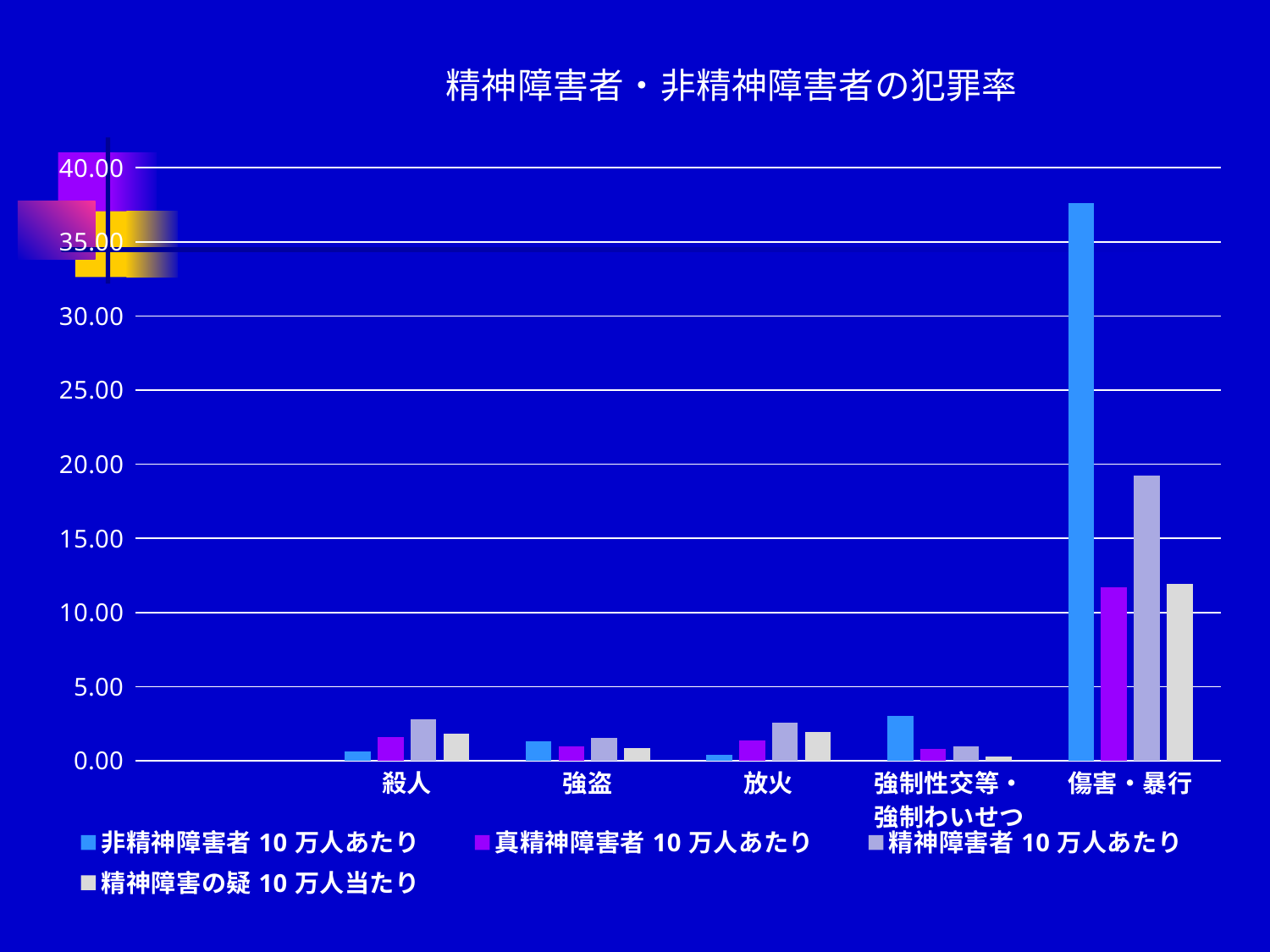
How many crime categories are shown on the x axis? 5 Which category has the highest value for 非精神障害者 10万人あたり? 傷害・暴行 Is the value for 精神障害者 10万人あたり in 傷害・暴行 greater or less than 15.00? greater Is the value for 精神障害者 10万人あたり in 殺人 greater or less than 5.00? less Is the value for 非精神障害者 10万人あたり in 傷害・暴行 greater or less than 30.00? greater What kind of chart is shown on the slide? bar chart In 傷害・暴行, which is larger: 精神障害者 10万人あたり or 真精神障害者 10万人あたり? 精神障害者 10万人あたり How many series does the legend list? 4 In 傷害・暴行, which is larger: 非精神障害者 10万人あたり or 精神障害者 10万人あたり? 非精神障害者 10万人あたり Which series is shown in purple in the legend? 真精神障害者 10万人あたり What is the title of the chart? 精神障害者・非精神障害者の犯罪率